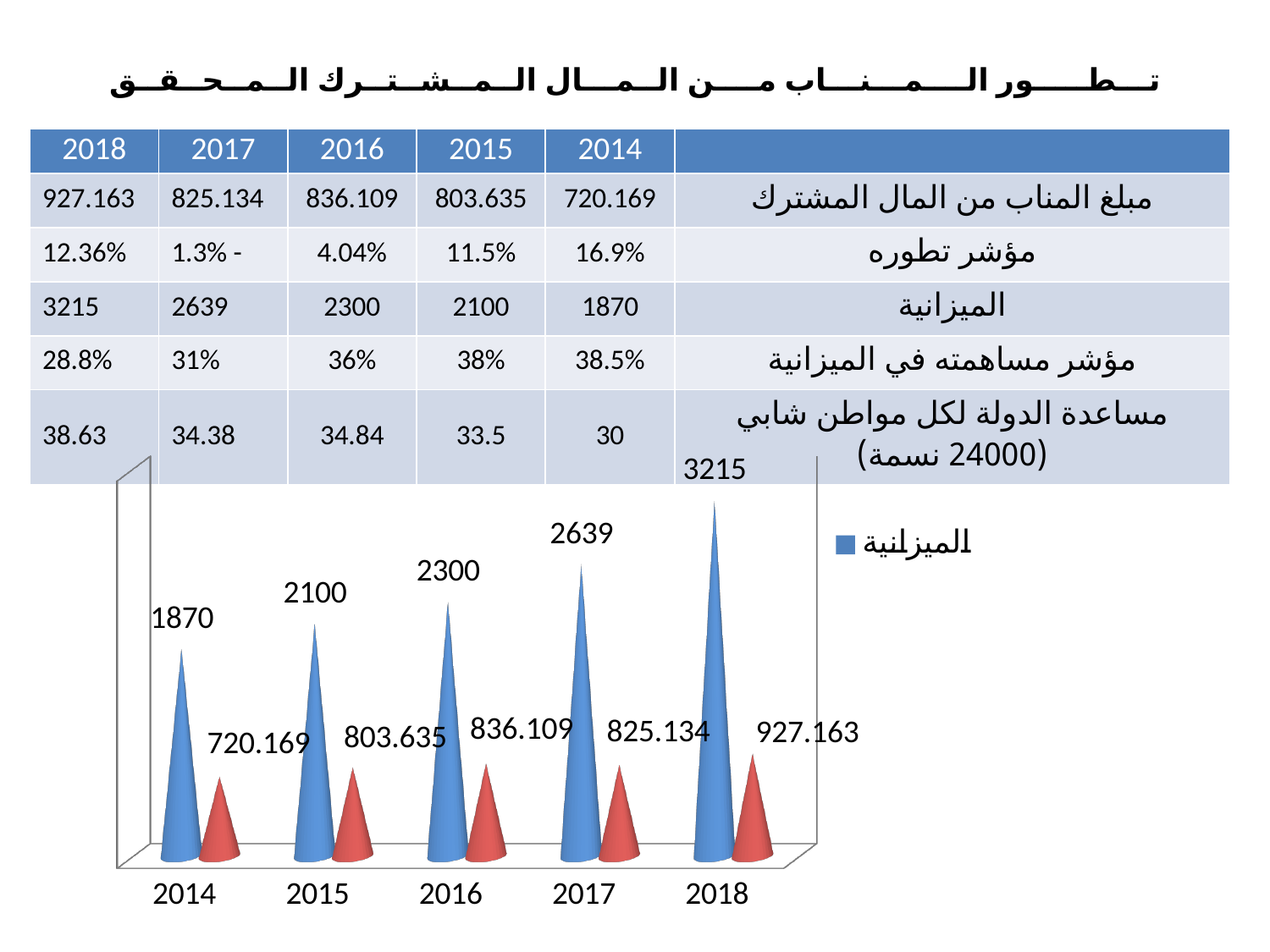
What colour are the bars for the الميزانية series in the chart? blue How many years are shown on the x axis of the chart? 5 What is the value of the blue series (الميزانية) for 2018 in the chart? 3215 Does the blue series (الميزانية) rise or fall from 2014 to 2018 in the chart? rise What is the difference between the blue series values for 2018 and 2017 in the chart? 576 Which is larger in the chart: the red series value for 2016 or for 2017? 2016 In which year is the blue series (الميزانية) highest in the chart? 2018 What is the value of the blue series (الميزانية) for 2014 in the chart? 1870 What is the value of the red series for 2017 in the chart? 825.134 In which year is the red series lowest in the chart? 2014 What type of chart is shown on the slide? bar chart What is the value of the red series for 2016 in the chart? 836.109